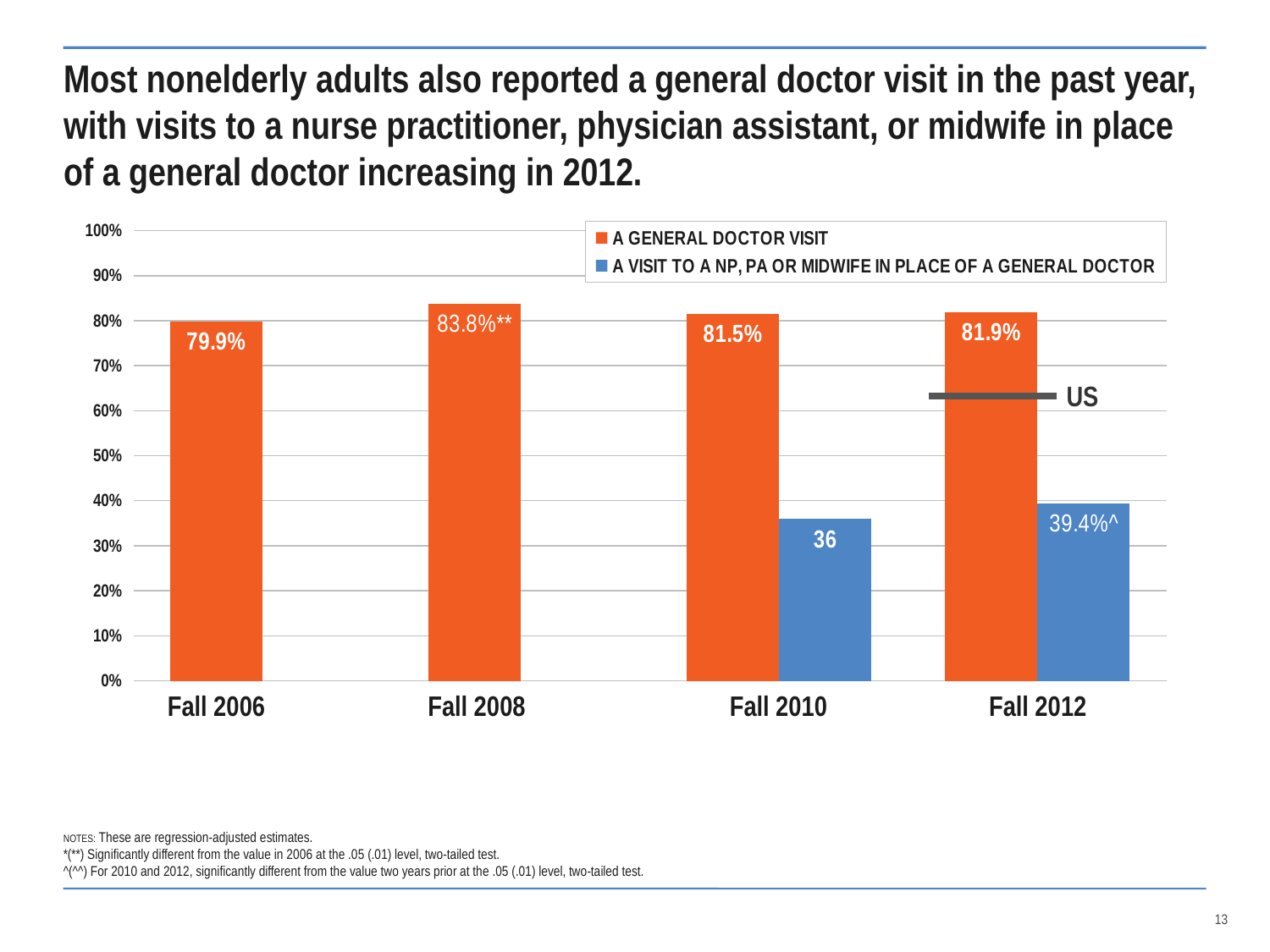
In which period was the share reporting a general doctor visit lowest? Fall 2006 How many series does the legend list? 2 By how many percentage points did the general doctor visit rate in Fall 2008 exceed that in Fall 2006? 3.9 percentage points What is the value for a general doctor visit in Fall 2008? 83.8% How many time periods are shown on the x axis? 4 Is the US reference line shown next to the Fall 2012 bars greater or less than 60%? greater What percentage of nonelderly adults reported a general doctor visit in Fall 2006? 79.9% What is the value for a visit to a NP, PA or midwife in place of a general doctor in Fall 2012? 39.4% What is the data label on the bar for a visit to a NP, PA or midwife in place of a general doctor in Fall 2010? 36 Which period had a higher general doctor visit rate, Fall 2010 or Fall 2012? Fall 2012 In which period was the share reporting a general doctor visit highest? Fall 2008 Did the share visiting a NP, PA or midwife in place of a general doctor rise or fall from Fall 2010 to Fall 2012? rise